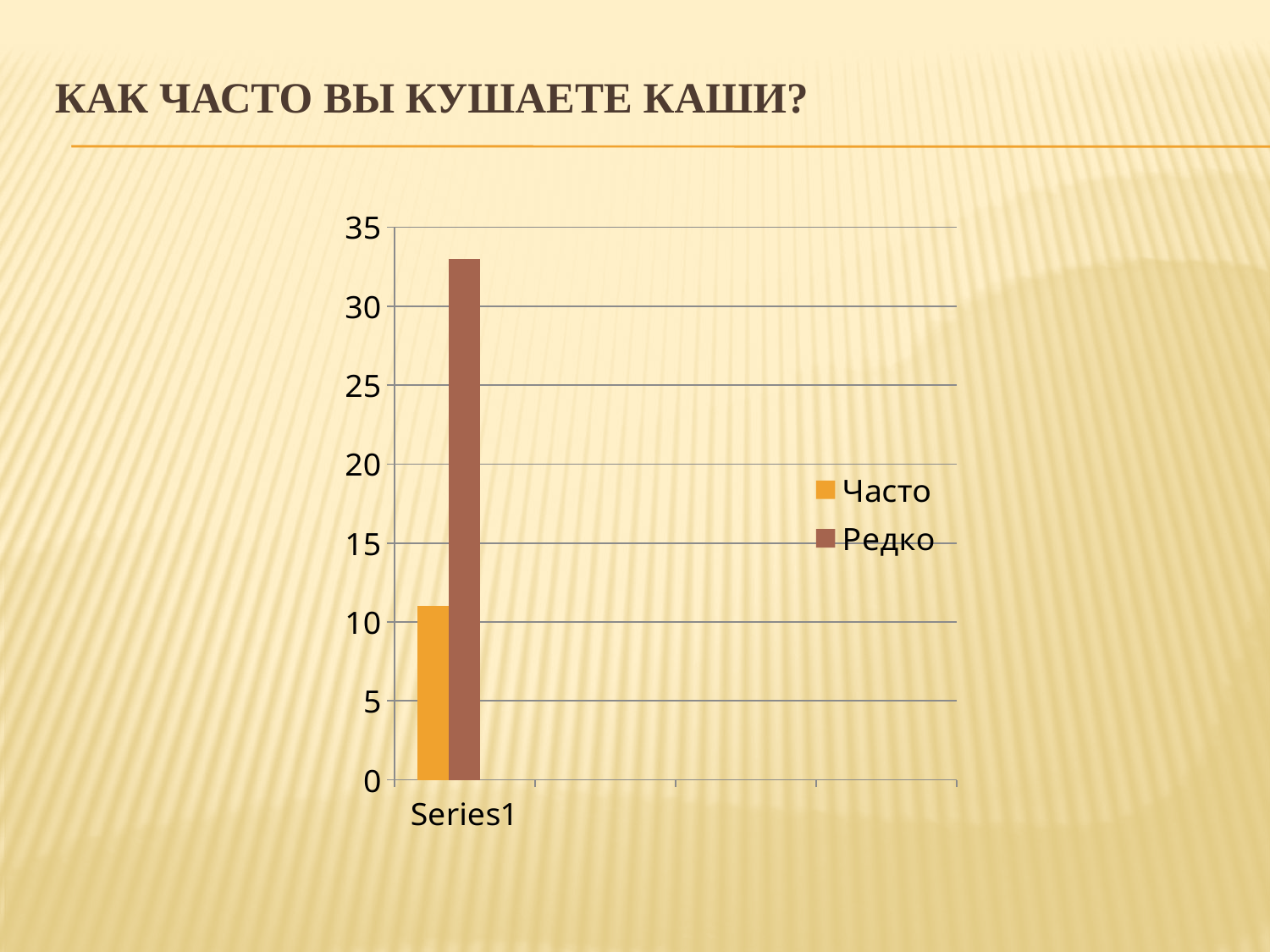
Which series has the highest value? Редко Which series has the lowest value? Часто Is the value for Редко greater or less than 30? greater Is the value for Часто greater or less than 15? less Is the value for Редко greater or less than 35? less How many categories are shown on the x axis? 1 Which series has the taller bar, Часто or Редко? Редко What is the title of the slide above the chart? КАК ЧАСТО ВЫ КУШАЕТЕ КАШИ? How many series does the legend list? 2 What kind of chart is shown on the slide? bar chart Which colour represents the series Часто in the legend? orange